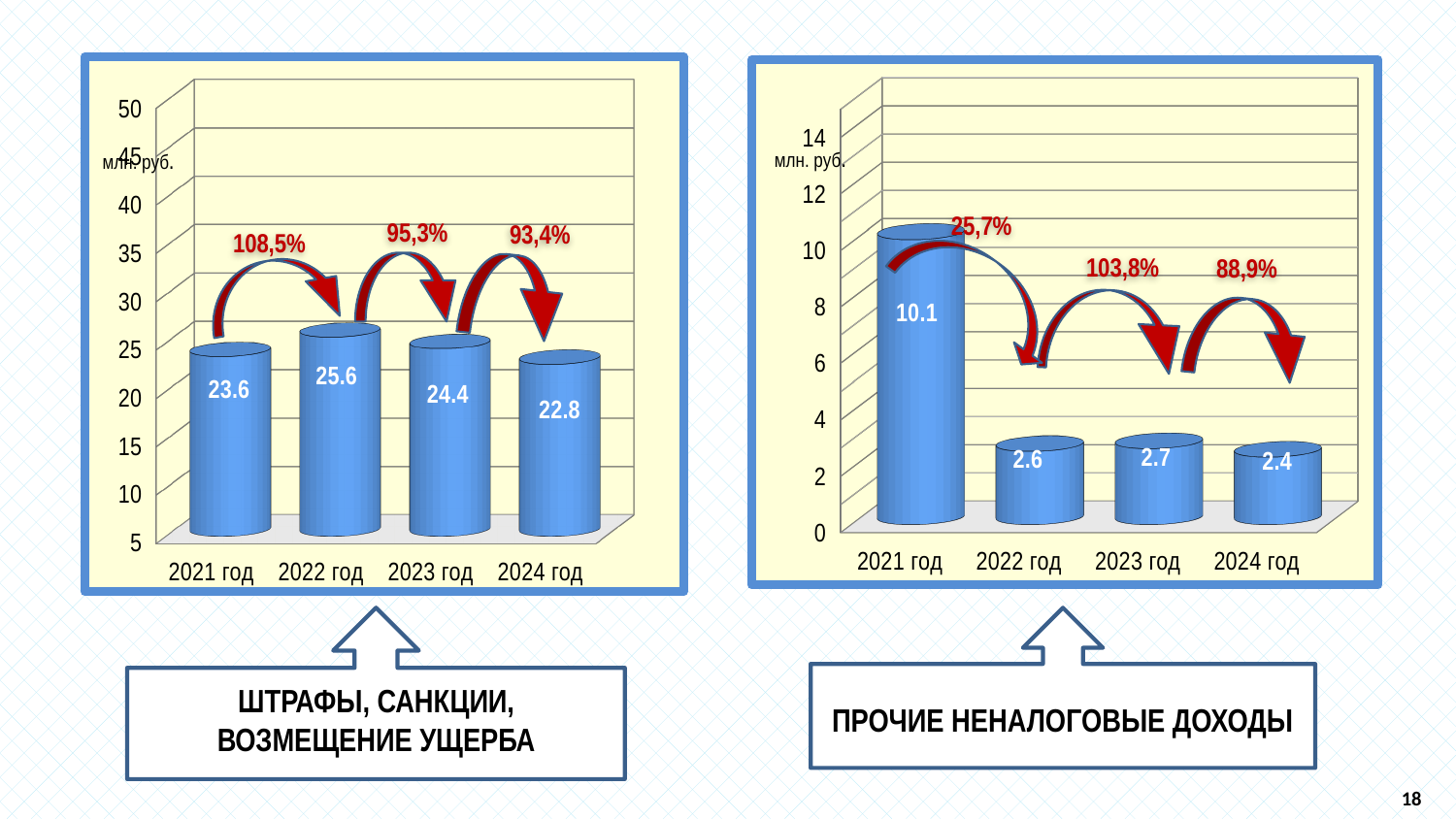
On the right chart (ПРОЧИЕ НЕНАЛОГОВЫЕ ДОХОДЫ), what is the value for 2021 год? 10.1 On the right chart (ПРОЧИЕ НЕНАЛОГОВЫЕ ДОХОДЫ), which year has the highest value? 2021 год On the left chart (ШТРАФЫ, САНКЦИИ, ВОЗМЕЩЕНИЕ УЩЕРБА), what is the value for 2022 год? 25.6 On the right chart (ПРОЧИЕ НЕНАЛОГОВЫЕ ДОХОДЫ), what is the value for 2024 год? 2.4 How many years are shown on the left chart (ШТРАФЫ, САНКЦИИ, ВОЗМЕЩЕНИЕ УЩЕРБА)? 4 On the right chart (ПРОЧИЕ НЕНАЛОГОВЫЕ ДОХОДЫ), is the value for 2021 год greater or less than 8? greater On the left chart (ШТРАФЫ, САНКЦИИ, ВОЗМЕЩЕНИЕ УЩЕРБА), which year has the lowest value? 2024 год What kind of chart is the right chart (ПРОЧИЕ НЕНАЛОГОВЫЕ ДОХОДЫ)? Bar chart On the left chart (ШТРАФЫ, САНКЦИИ, ВОЗМЕЩЕНИЕ УЩЕРБА), which year has the highest value? 2022 год On the left chart (ШТРАФЫ, САНКЦИИ, ВОЗМЕЩЕНИЕ УЩЕРБА), what percentage label is shown on the arrow between 2021 год and 2022 год? 108,5% On the right chart (ПРОЧИЕ НЕНАЛОГОВЫЕ ДОХОДЫ), what is the difference between the values for 2021 год and 2022 год? 7.5 On the left chart (ШТРАФЫ, САНКЦИИ, ВОЗМЕЩЕНИЕ УЩЕРБА), what is the difference between the values for 2022 год and 2024 год? 2.8